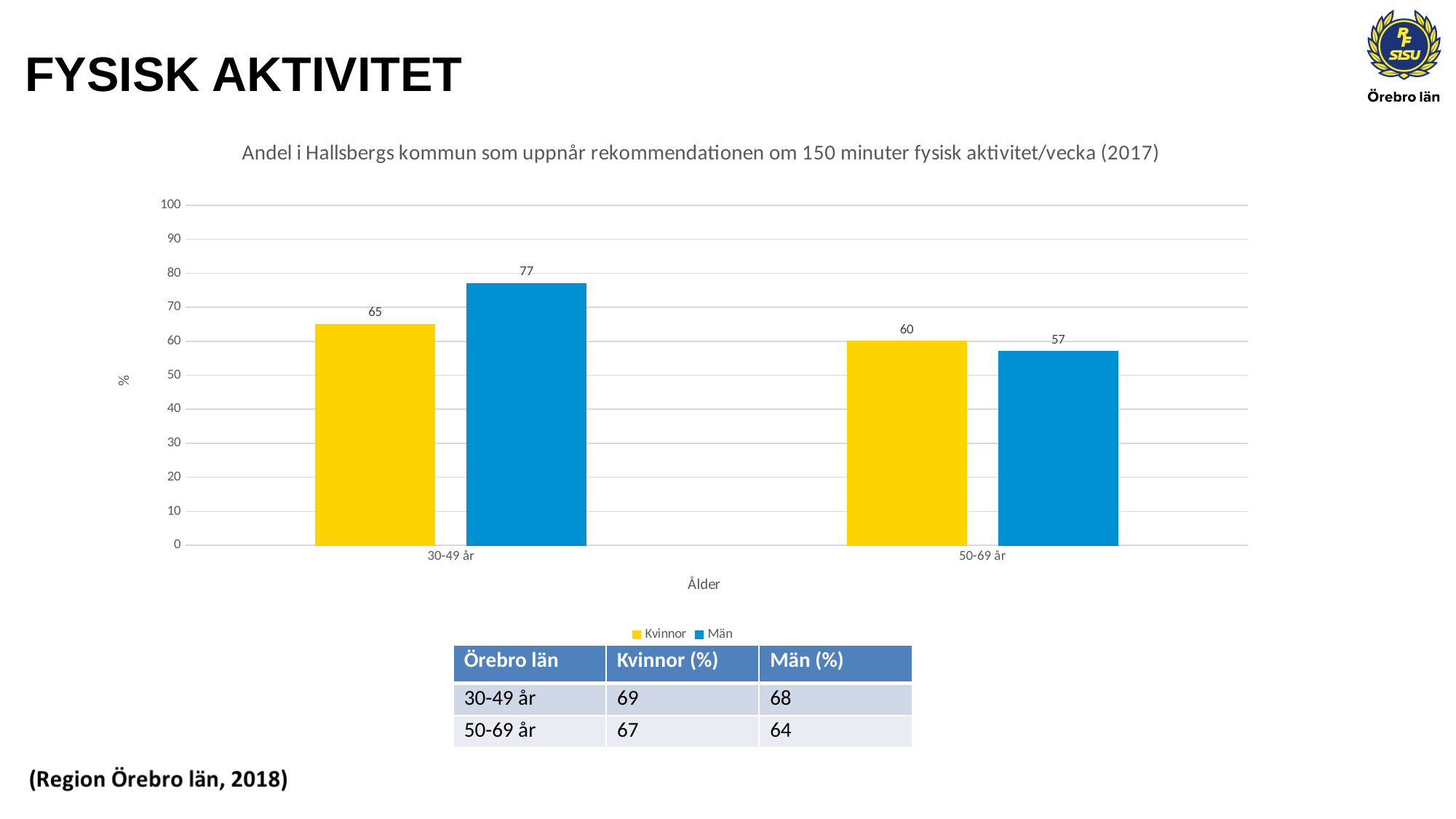
What is the difference between Kvinnor and Män in the 50-69 år age group? 3 What is the difference between Män and Kvinnor in the 30-49 år age group? 12 What is the value for Kvinnor in the 50-69 år age group? 60 What is the value for Män in the 50-69 år age group? 57 How many series does the legend list? 2 What kind of chart is shown on the slide? Bar chart Which bar has the lowest value in the chart? Män, 50-69 år Which bar has the highest value in the chart? Män, 30-49 år What is the value for Kvinnor in the 30-49 år age group? 65 What is the value for Män in the 30-49 år age group? 77 Which is larger in the 50-69 år age group, Kvinnor or Män? Kvinnor How many age groups are shown on the x axis? 2